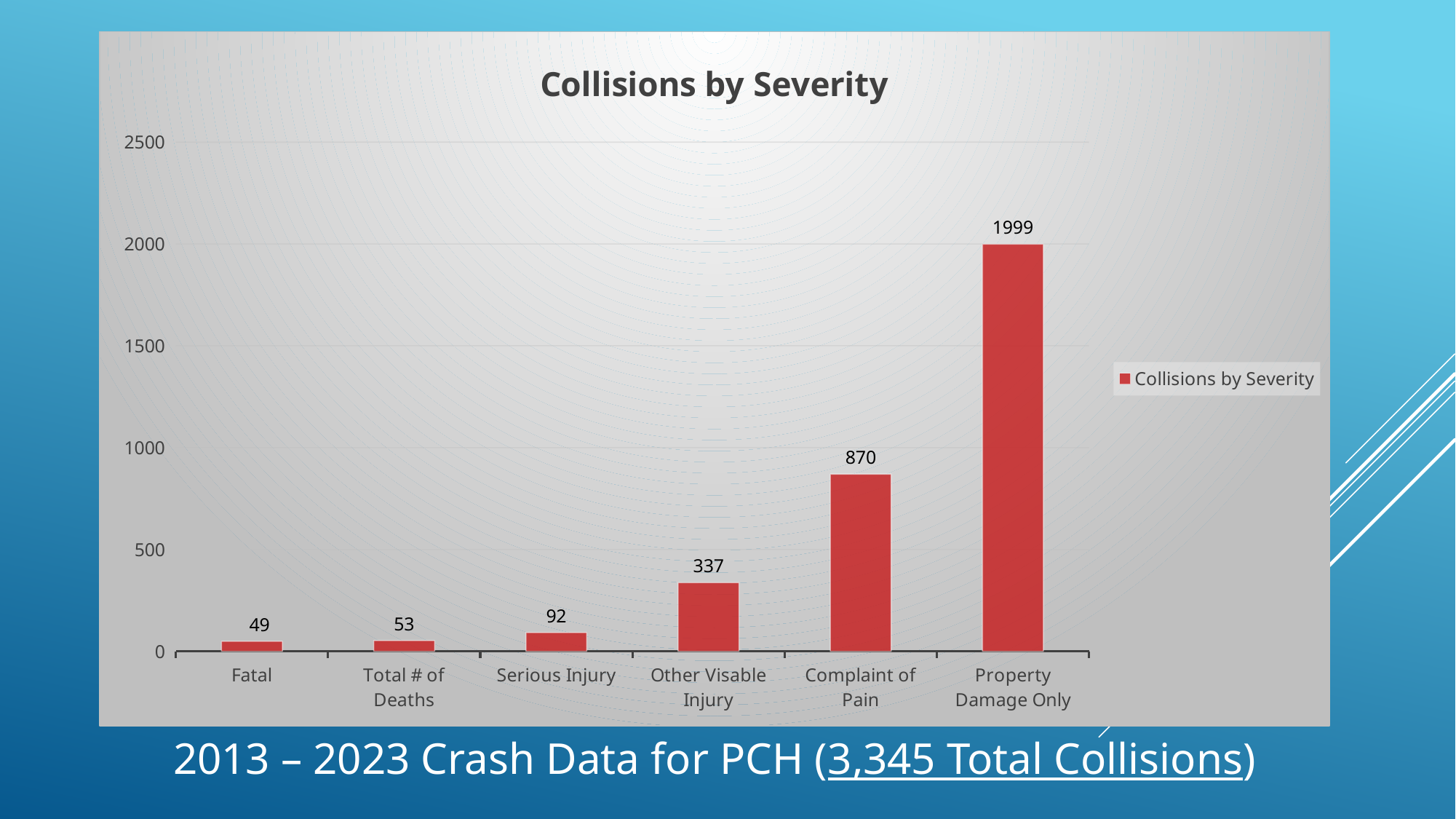
What is the difference between Property Damage Only and Complaint of Pain? 1129 How many categories are shown on the x axis? 6 What is the title of the chart? Collisions by Severity What is the value for Other Visable Injury? 337 Which is larger, Serious Injury or Other Visable Injury? Other Visable Injury What is the value for Property Damage Only? 1999 Is the value for Complaint of Pain greater or less than 1000? less Which category has the highest value? Property Damage Only What kind of chart is this? bar chart What is the value for Complaint of Pain? 870 Which category has the lowest value? Fatal What is the value for Fatal? 49